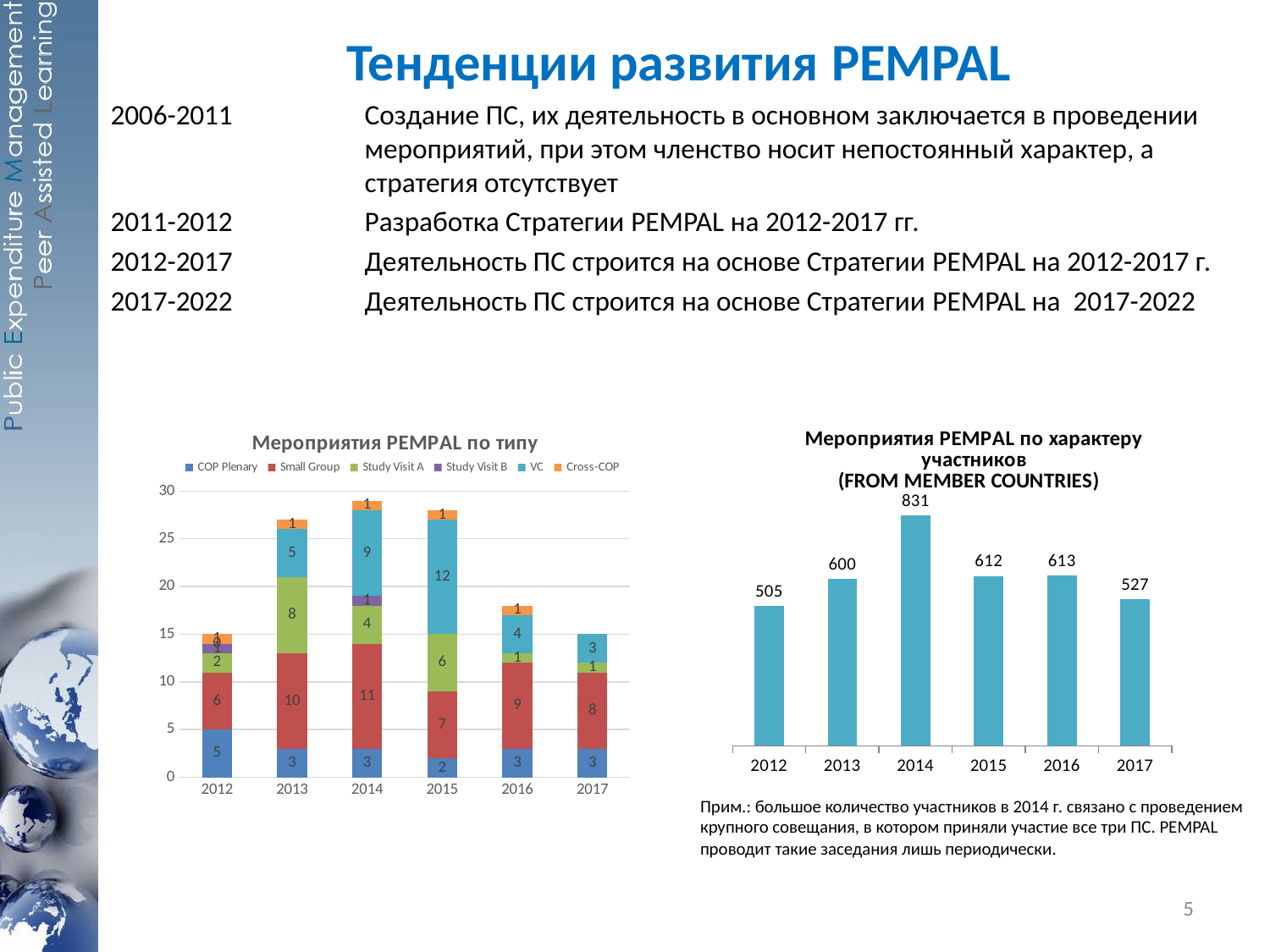
In the chart 'Мероприятия PEMPAL по типу', what is the value for Small Group in 2014? 11 In the chart 'Мероприятия PEMPAL по характеру участников (FROM MEMBER COUNTRIES)', which is larger, the value for 2013 or for 2017? 2013 In the chart 'Мероприятия PEMPAL по типу', what is the total of the stacked bar for 2013? 27 In the chart 'Мероприятия PEMPAL по характеру участников (FROM MEMBER COUNTRIES)', what is the value for 2014? 831 What kind of chart is 'Мероприятия PEMPAL по характеру участников (FROM MEMBER COUNTRIES)'? bar chart In the chart 'Мероприятия PEMPAL по типу', is the total for 2014 greater or less than 25? greater In the chart 'Мероприятия PEMPAL по характеру участников (FROM MEMBER COUNTRIES)', which year has the lowest value? 2012 How many years are shown in the chart 'Мероприятия PEMPAL по характеру участников (FROM MEMBER COUNTRIES)'? 6 In the chart 'Мероприятия PEMPAL по характеру участников (FROM MEMBER COUNTRIES)', which year has the highest value? 2014 In the chart 'Мероприятия PEMPAL по типу', what is the value for VC in 2015? 12 In the chart 'Мероприятия PEMPAL по характеру участников (FROM MEMBER COUNTRIES)', what is the difference between the values for 2014 and 2013? 231 How many series does the legend of the chart 'Мероприятия PEMPAL по типу' list? 6